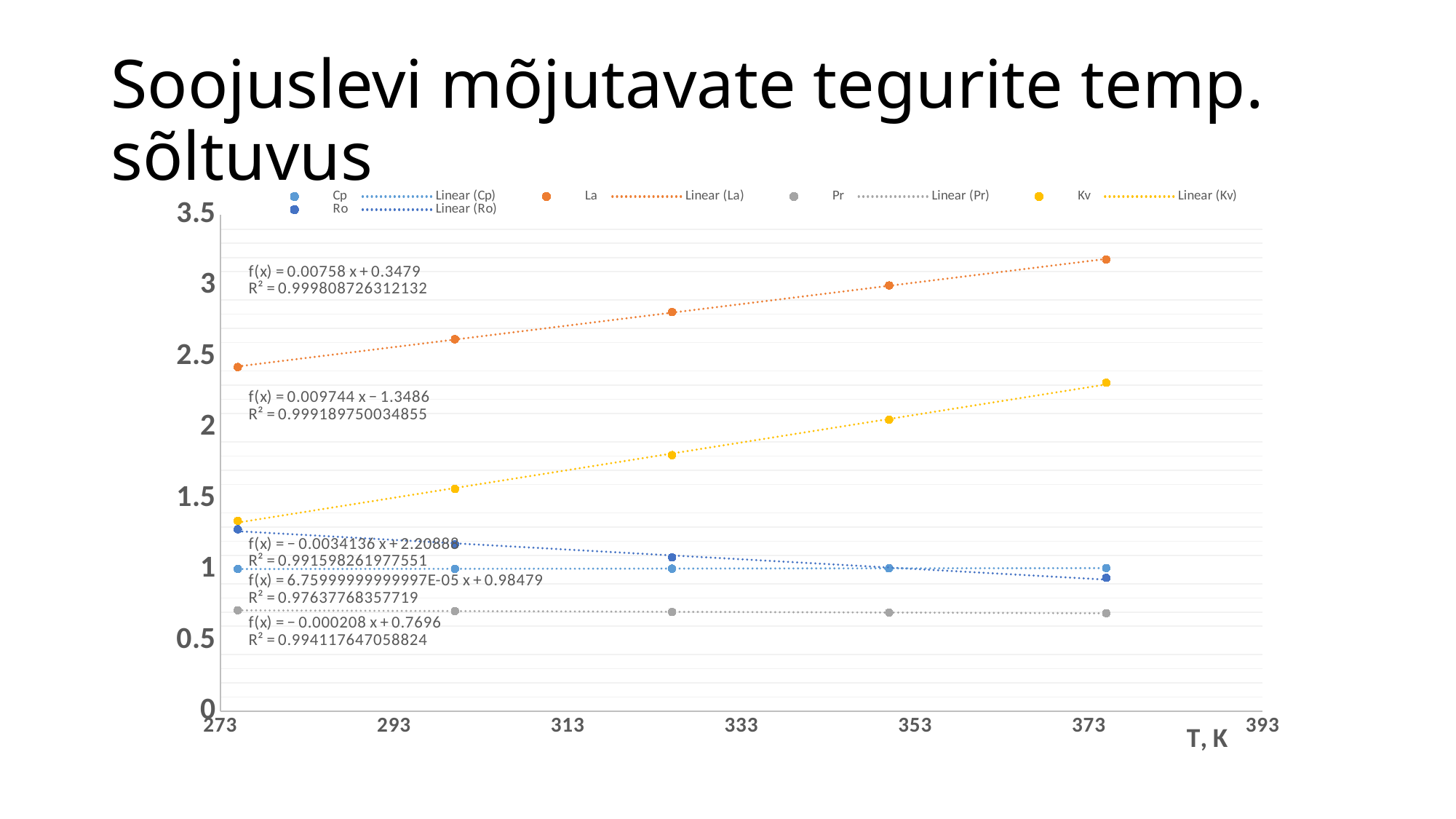
Is the value of the Kv series at its lowest temperature point greater or less than 1.5? less Which series has the highest values across the whole temperature range? La Which series has the lowest values across the whole temperature range? Pr Do the values of the Kv series rise or fall as temperature increases? rise How many data series with markers (excluding the linear trendlines) are plotted on the chart? 5 Is the value of the La series at its highest temperature point greater or less than 3? greater At the highest temperature point, which series has the larger value, La or Kv? La What kind of chart is shown on the slide? scatter chart What is the label of the x axis? T, K How many entries does the chart legend list? 10 How many data points does the La series have? 5 Do the values of the Ro series rise or fall as temperature increases? fall